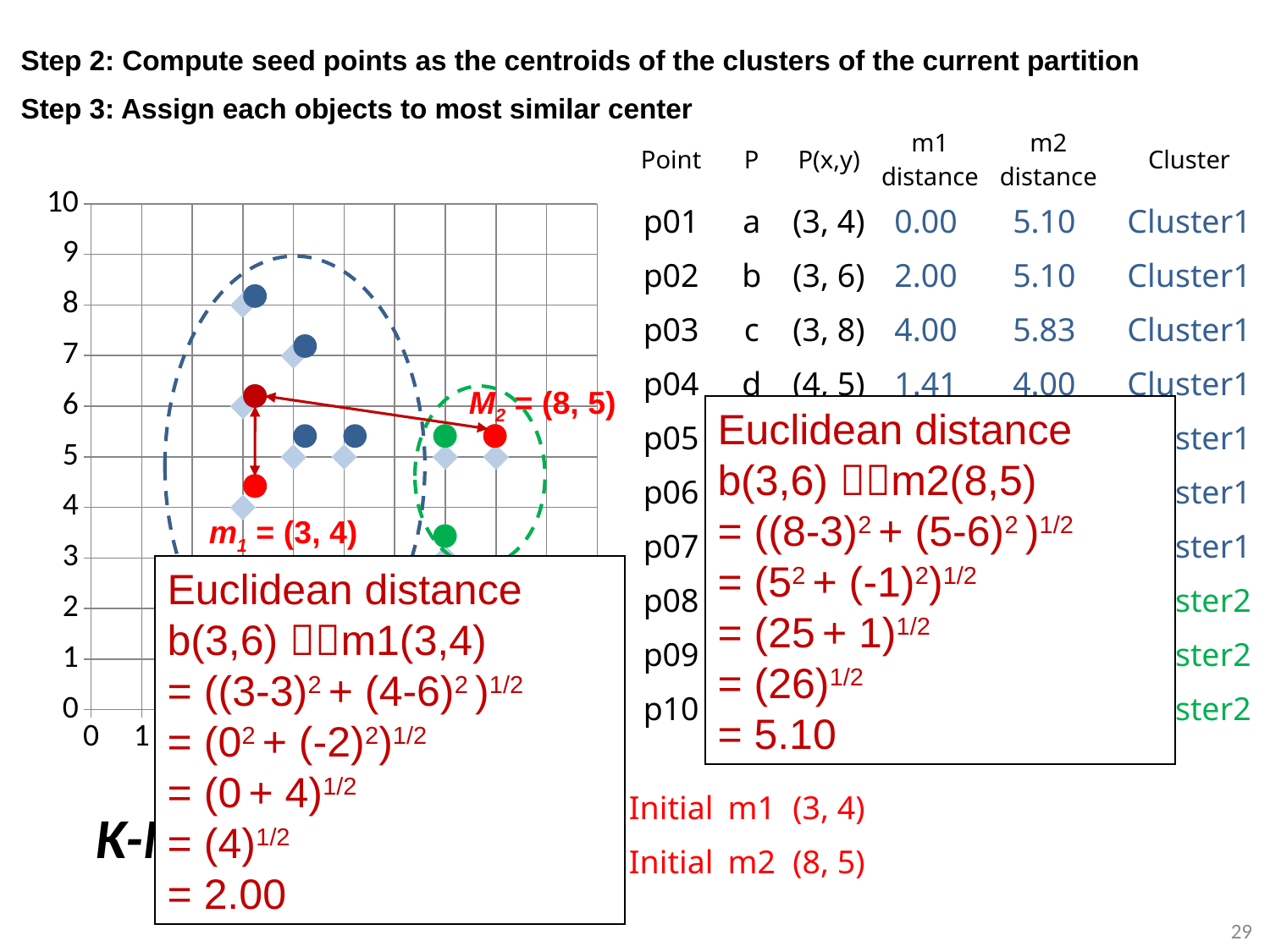
What is the highest value shown on the chart's y axis? 10 What are the coordinates labelled for M2 on the chart? (8, 5) What are the coordinates labelled for m1 on the chart? (3, 4) How many dashed ellipses are drawn around groups of points on the chart? 2 What is the difference between the y coordinates of M2 and m1 as labelled on the chart? 1 Which labelled centre, m1 or M2, has the larger x coordinate? M2 Is the x coordinate of M2 greater or less than 5? greater What colour are the markers for the centres m1 and M2 on the chart? red What kind of chart is shown on the left of the slide? scatter chart What is the difference between the x coordinates of M2 and m1 as labelled on the chart? 5 Is the y coordinate of m1 greater or less than 5? less